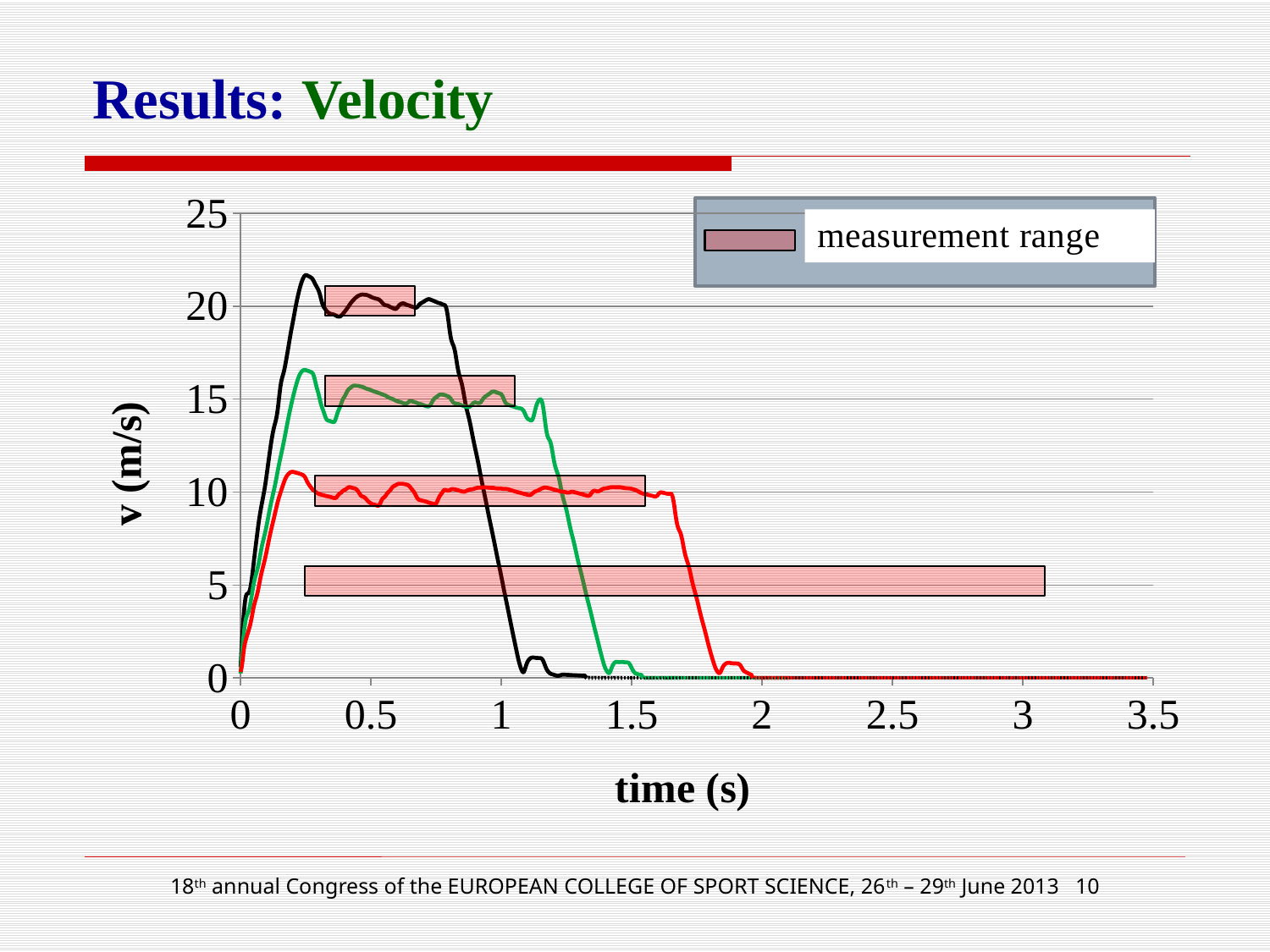
Is the peak velocity of the green curve greater or less than 15 m/s? greater How many coloured velocity curves are plotted on the chart? 3 What is the label of the x axis? time (s) Is the peak velocity of the red curve greater or less than 15 m/s? less Which curve drops to zero velocity later, the black curve or the red curve? red Is the peak velocity of the black curve greater or less than 20 m/s? greater How many entries does the legend list? 1 Does the black curve rise or fall between 1 s and 1.5 s on the x axis? fall Which coloured curve reaches the highest velocity? black What is the label of the y axis? v (m/s) Which coloured curve reaches the lowest peak velocity? red What kind of chart is shown on the slide? line chart